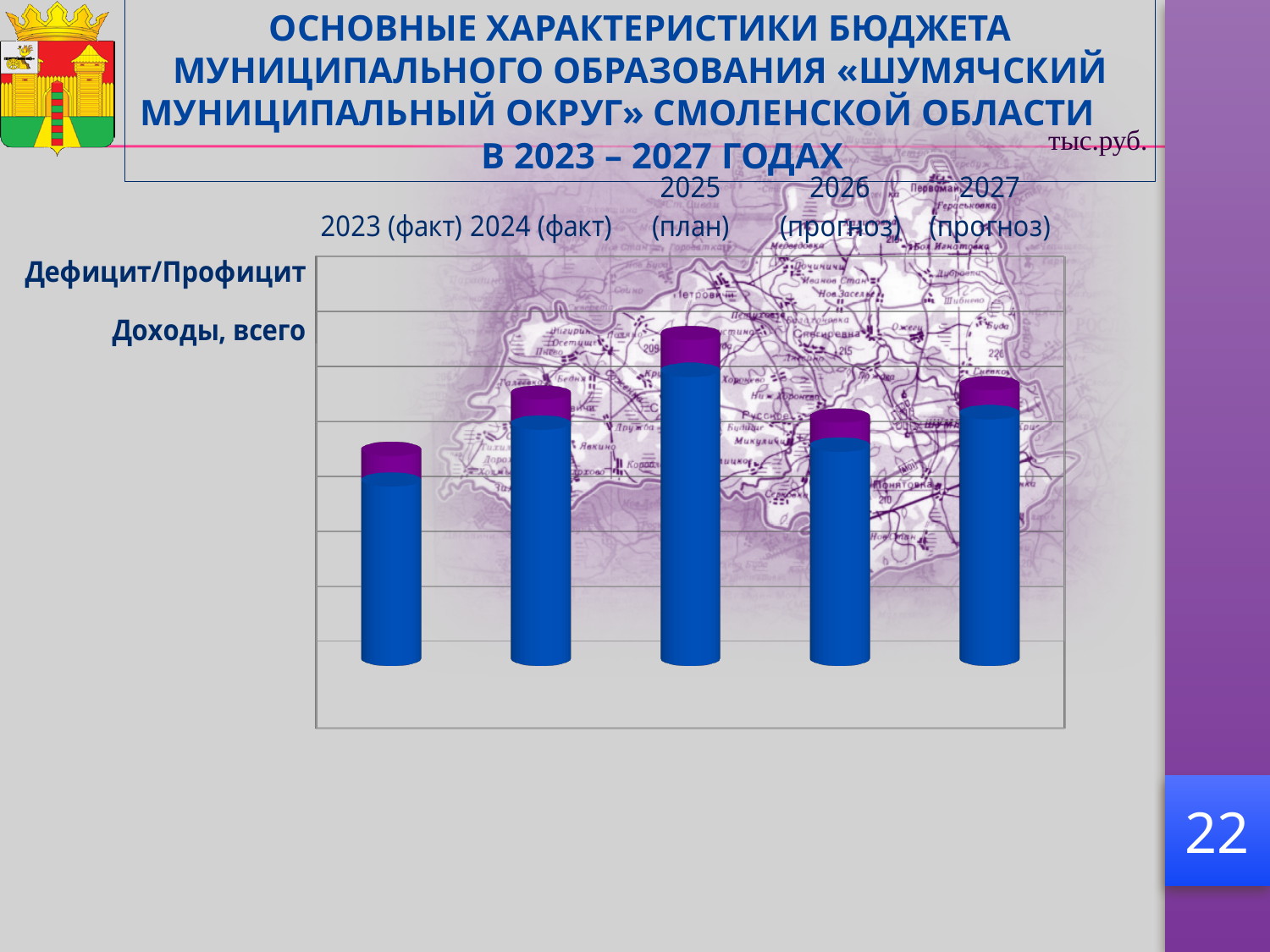
Which bar is taller, 2026 (прогноз) or 2023 (факт)? 2026 (прогноз) Which bar is taller, 2025 (план) or 2023 (факт)? 2025 (план) What kind of chart is shown on the slide? bar chart What unit of measurement is indicated for the chart? тыс.руб. Which year has the shortest bar on the chart? 2023 (факт) Do the bar heights rise or fall from 2025 (план) to 2026 (прогноз)? fall Do the bar heights rise or fall from 2023 (факт) to 2025 (план)? rise Which bar is taller, 2027 (прогноз) or 2026 (прогноз)? 2027 (прогноз) How many year categories are plotted on the chart? 5 Which year has the tallest bar on the chart? 2025 (план)